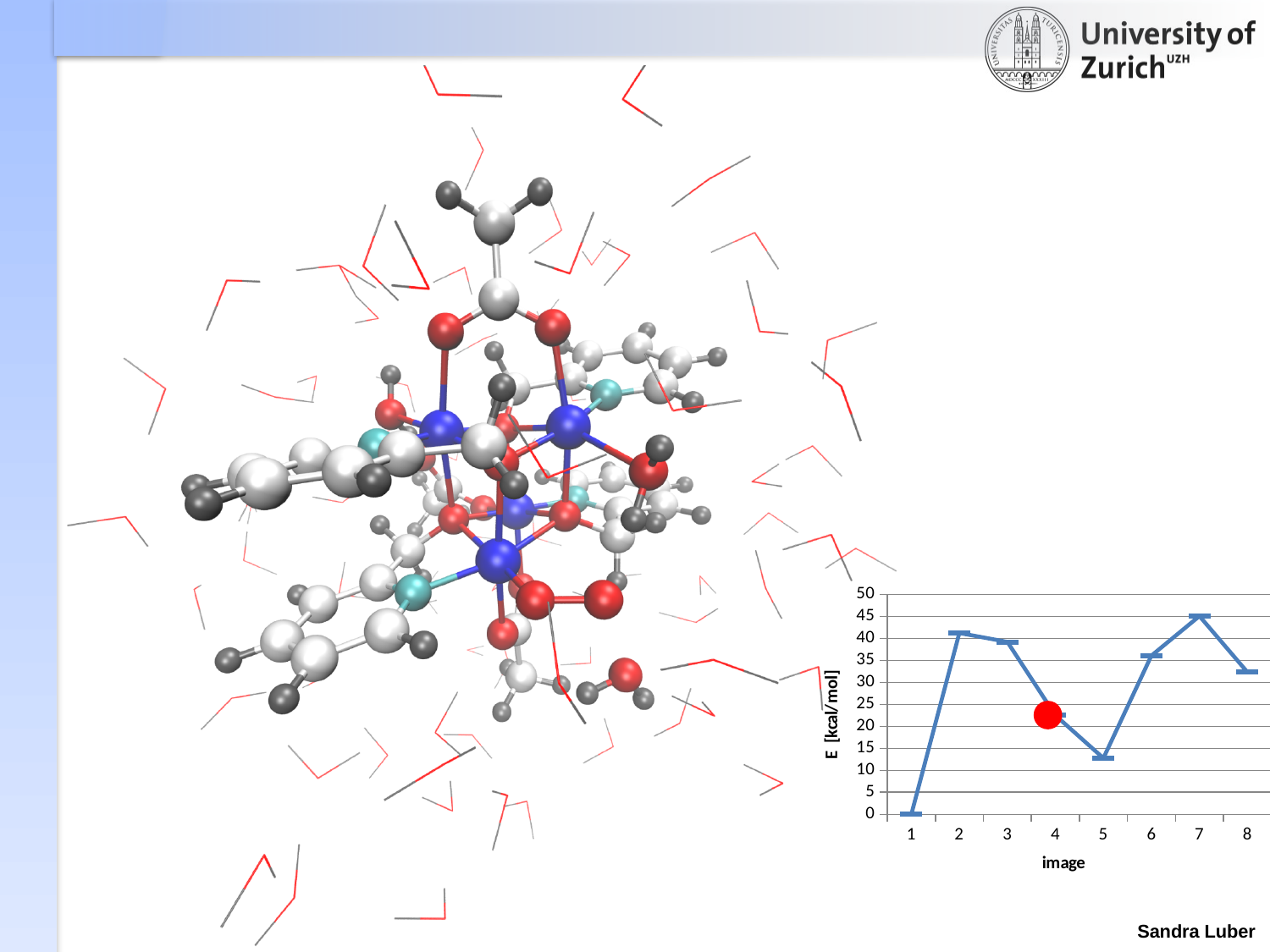
Is the energy value for image 4 greater or less than 30? less Which image has the lowest energy value in the chart? 1 Is the energy value for image 2 greater or less than 35? greater What is the label of the x axis of the chart? image Which image has the highest energy value in the chart? 7 How many image points are plotted along the x axis of the chart? 8 What is the label of the y axis of the chart? E [kcal/mol] What kind of chart is shown on the slide? line chart What is the energy value for image 1? 0 Is the energy value for image 5 greater or less than 15? less Which has the larger energy value, image 2 or image 5? image 2 Does the energy value rise or fall from image 4 to image 5? fall